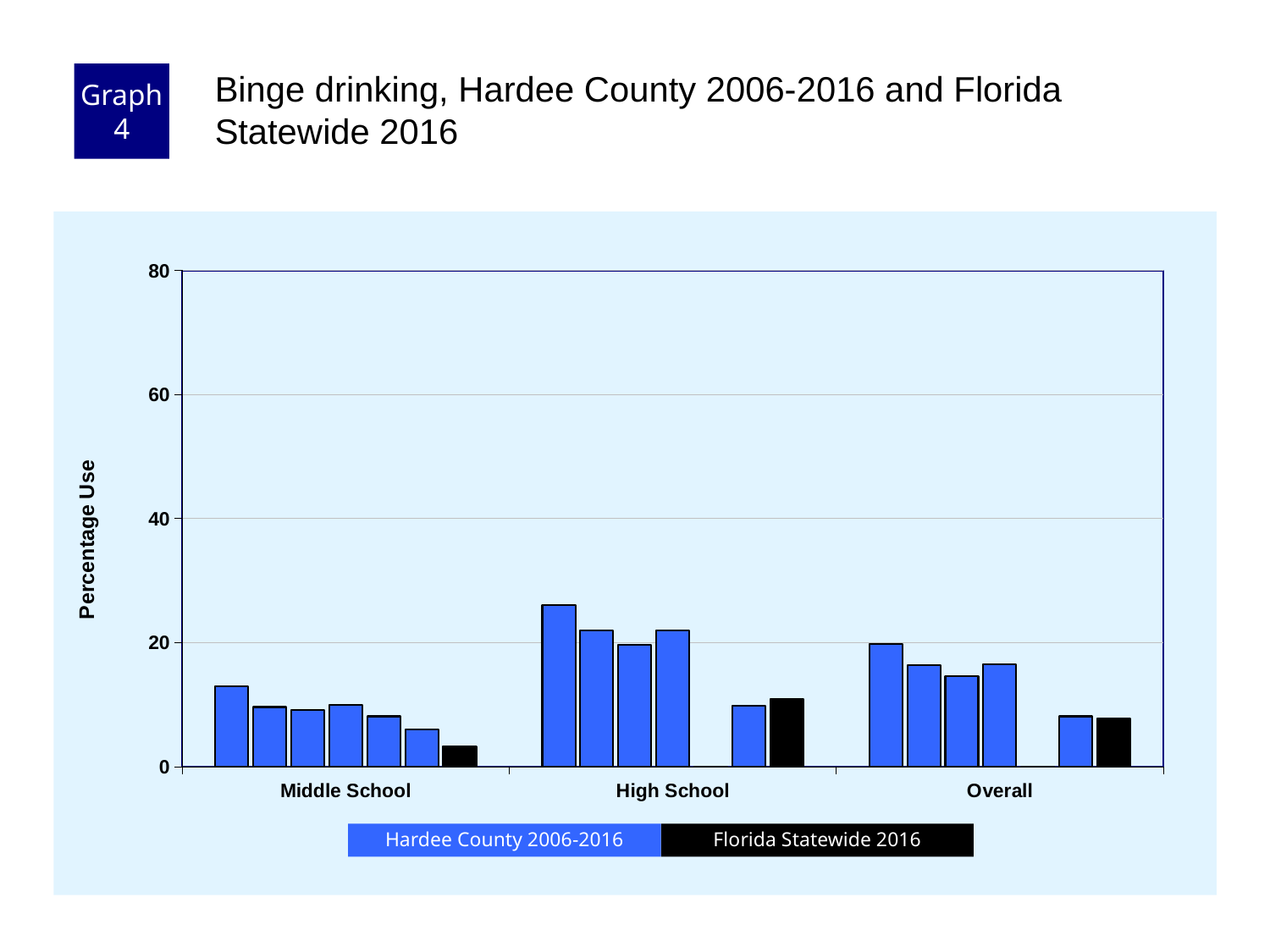
In the Middle School group, which is larger: the leftmost Hardee County bar or the Florida Statewide 2016 bar? the leftmost Hardee County bar How many series does the legend list? 2 How many categories are shown along the x axis? 3 Which category contains the tallest bar on the chart? High School What colour are the Florida Statewide 2016 bars? black Is the Florida Statewide 2016 value for Middle School greater or less than 20? less What is the title of the y axis? Percentage Use Is the tallest Hardee County bar in the High School group greater or less than 20? greater What kind of chart is shown on the slide? bar chart Which category has the lowest Florida Statewide 2016 value? Middle School Is the tallest Hardee County bar in the Middle School group greater or less than 20? less